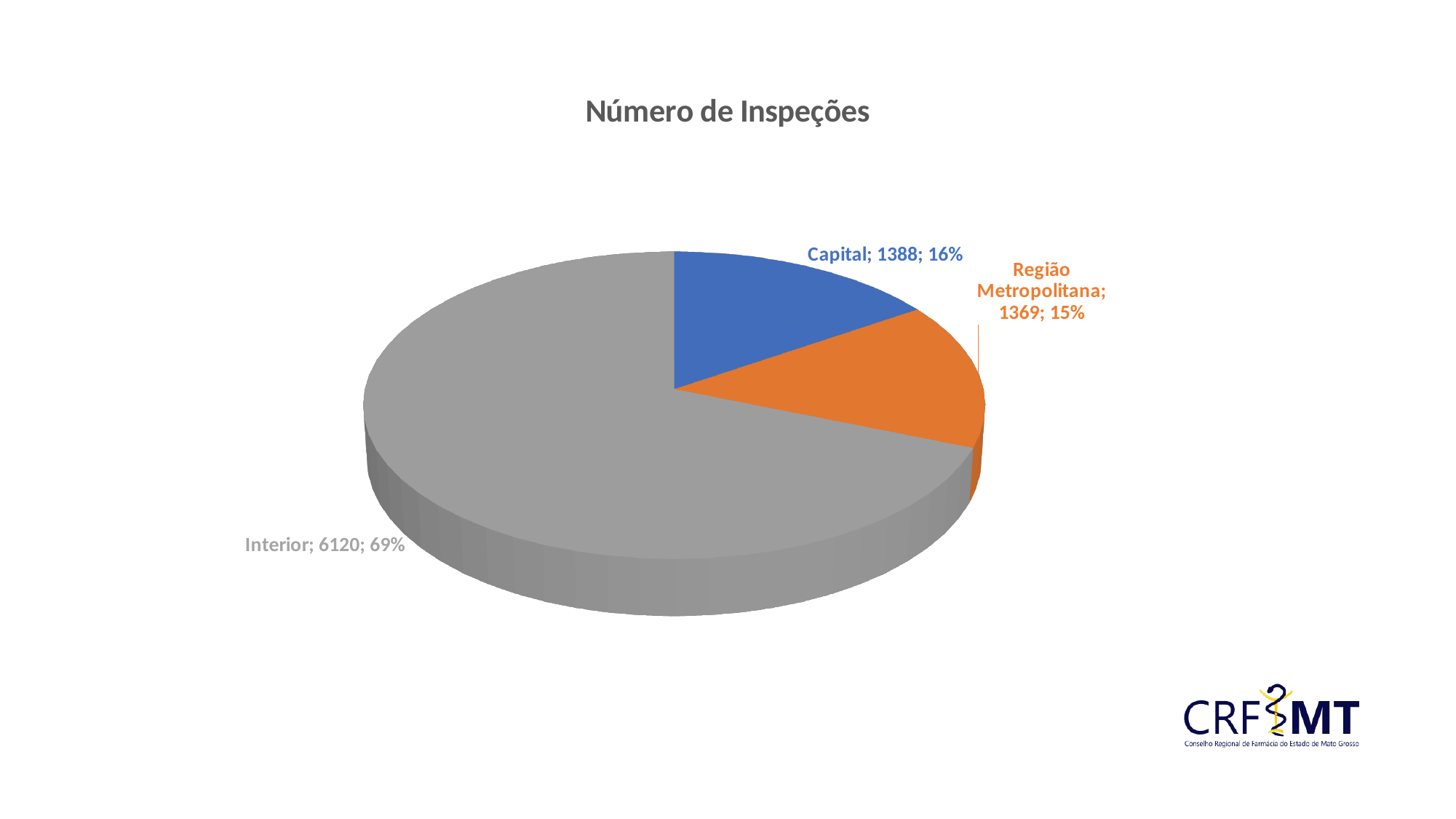
What share of the pie does Interior represent? 69% How many categories are shown in the pie chart? 3 What is the difference in inspections between Capital and Região Metropolitana? 19 What is the title of the chart? Número de Inspeções What is the number of inspections for Região Metropolitana? 1369 Which category has the highest number of inspections? Interior What is the difference in inspections between Interior and Capital? 4732 What kind of chart is shown on the slide? Pie chart What is the number of inspections for Capital? 1388 What is the number of inspections for Interior? 6120 What share of the pie does Capital represent? 16% Which category has the lowest number of inspections? Região Metropolitana